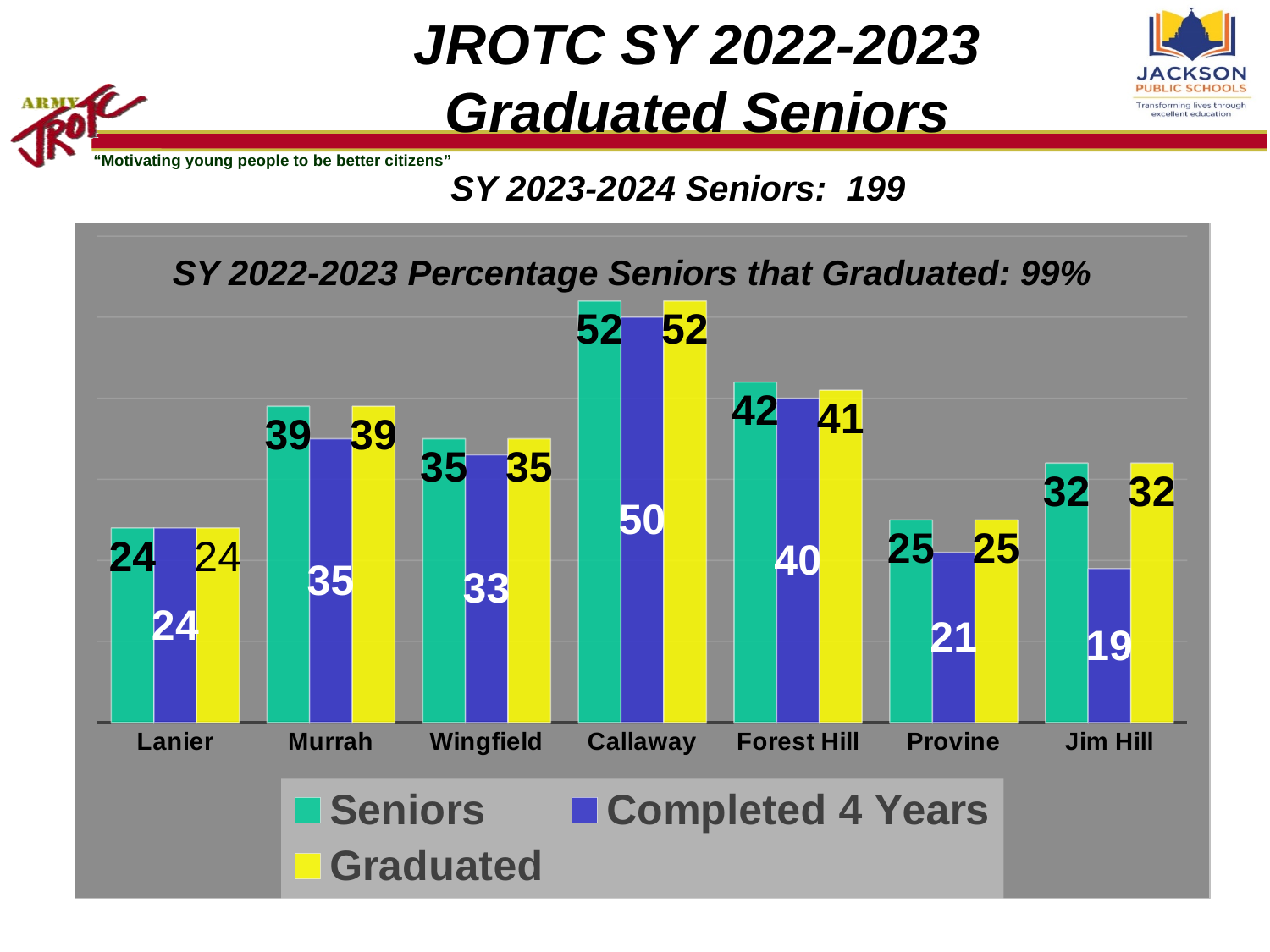
What is the Completed 4 Years value for Jim Hill? 19 How many Graduated seniors are shown for Forest Hill? 41 Which school has the highest number of Seniors? Callaway How many series does the chart legend list? 3 What percentage of SY 2022-2023 seniors graduated, according to the chart title? 99% Which series is shown in yellow in the chart legend? Graduated Which school has the lowest Completed 4 Years value? Jim Hill How many Seniors does the chart show for Callaway? 52 What kind of chart is shown on the slide? Bar chart How many schools are shown on the x axis of the chart? 7 What is the difference between Seniors and Completed 4 Years for Jim Hill? 13 Which is larger for Provine: the Seniors value or the Completed 4 Years value? Seniors